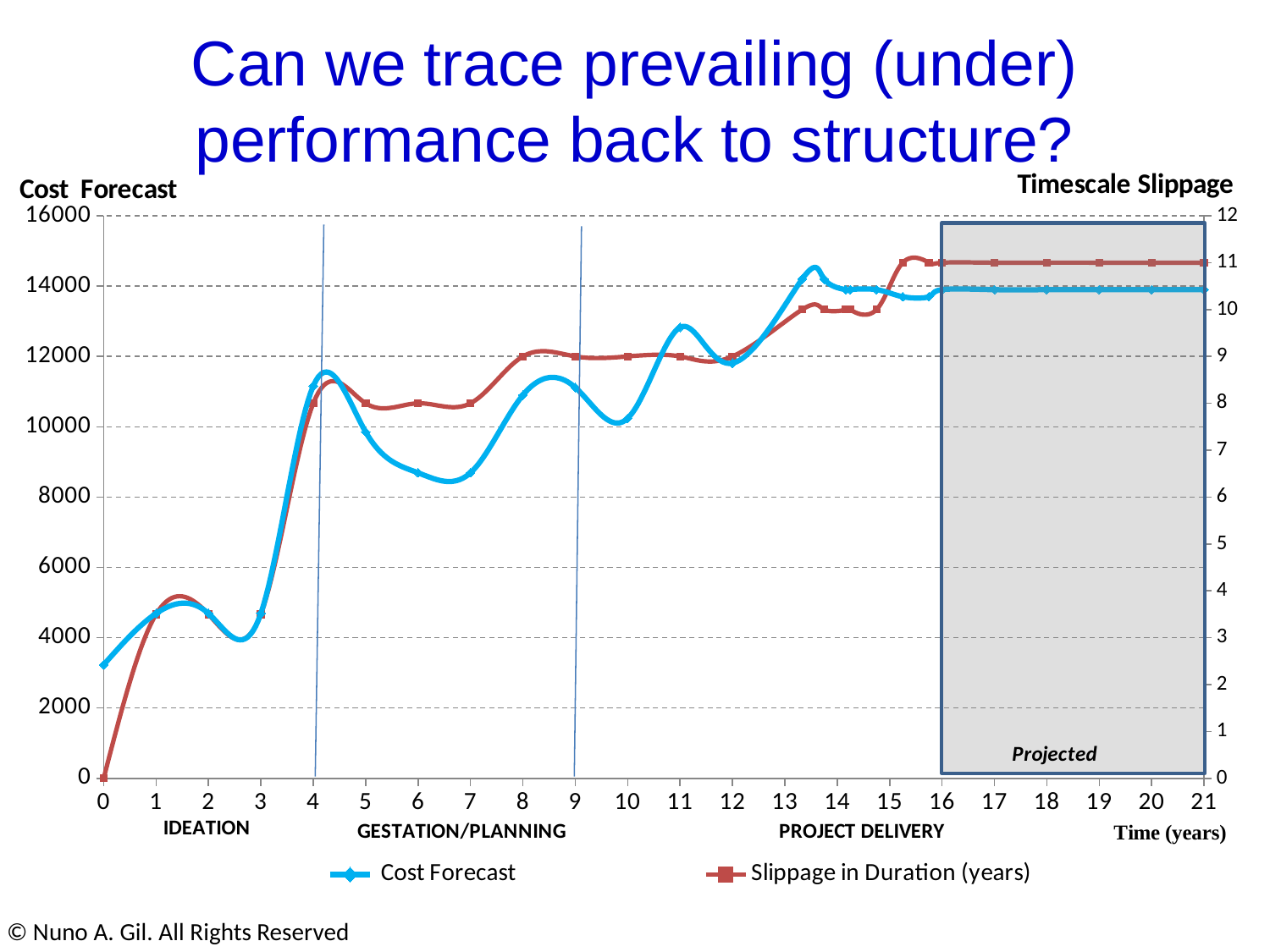
Is the Slippage in Duration (years) value at time 21 greater or less than 10? greater Is the Cost Forecast value at time 7 greater or less than 8000? greater Is the Slippage in Duration (years) value at time 2 greater or less than 3? greater What are the two series named in the legend? Cost Forecast and Slippage in Duration (years) What kind of chart is shown on the slide? line chart At which time (years) is the Cost Forecast lowest? 0 What is the title of the right-hand vertical axis? Timescale Slippage What is the value of Slippage in Duration (years) at time 0? 0 Does the Slippage in Duration (years) series generally rise or fall from time 0 to time 21? rise How many series does the legend list? 2